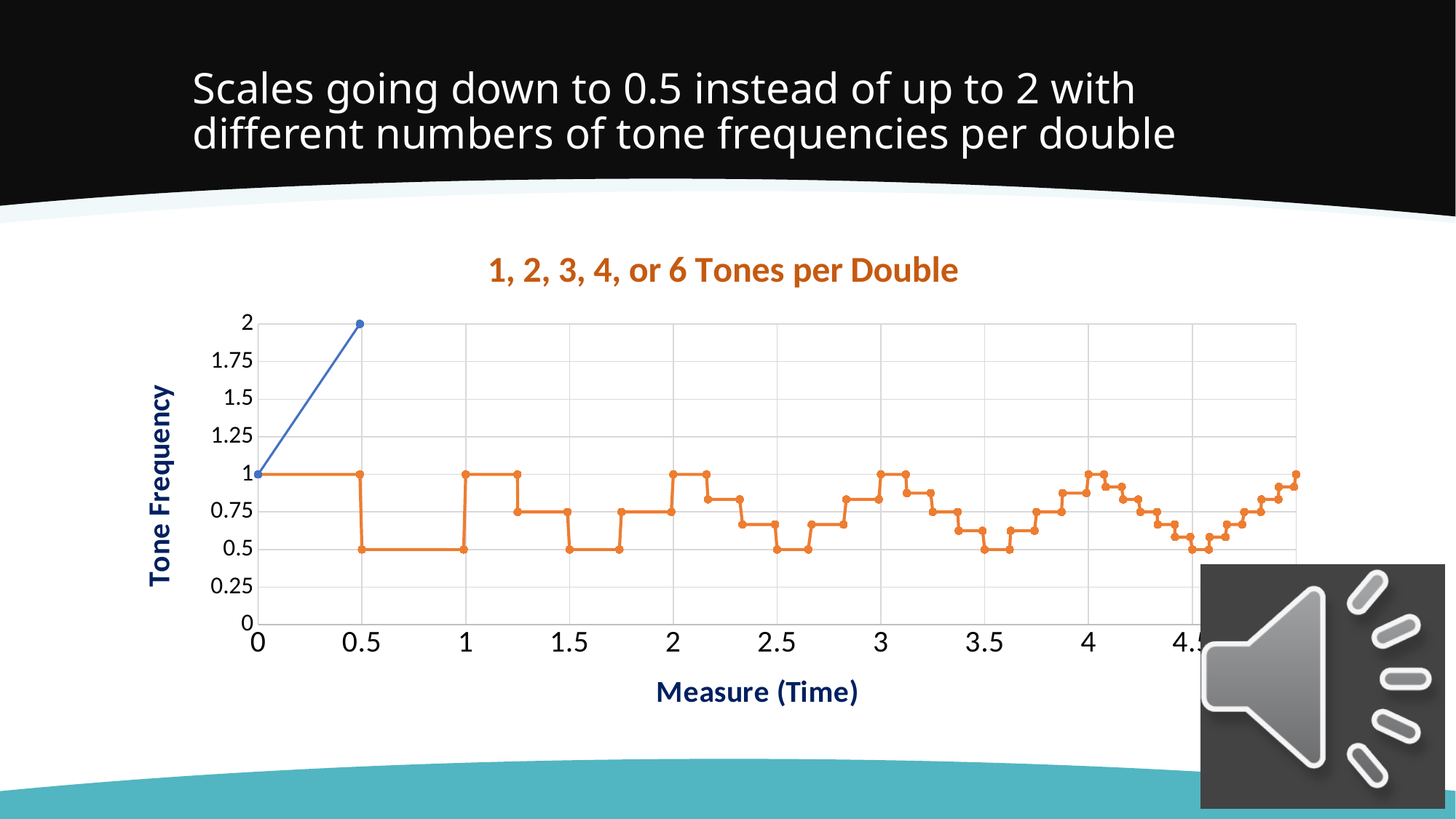
What is the lowest Tone Frequency value reached by the orange line? 0.5 Is the value of the orange line at Measure (Time) 4.5 greater or less than 0.75? less What is the highest Tone Frequency value plotted on the chart? 2 What is the value of the orange line at Measure (Time) 0? 1 What is the title of the chart? 1, 2, 3, 4, or 6 Tones per Double What is the value of the orange line at Measure (Time) 3? 1 Is the value of the orange line at Measure (Time) 2.25 greater or less than 0.75? greater What is the value of the blue line at Measure (Time) 0.5? 2 What is the label of the vertical axis of the chart? Tone Frequency What kind of chart is shown on the slide? Line chart Does the blue line rise or fall between Measure (Time) 0 and 0.5? rise What is the value of the orange line at Measure (Time) 1.5? 0.5